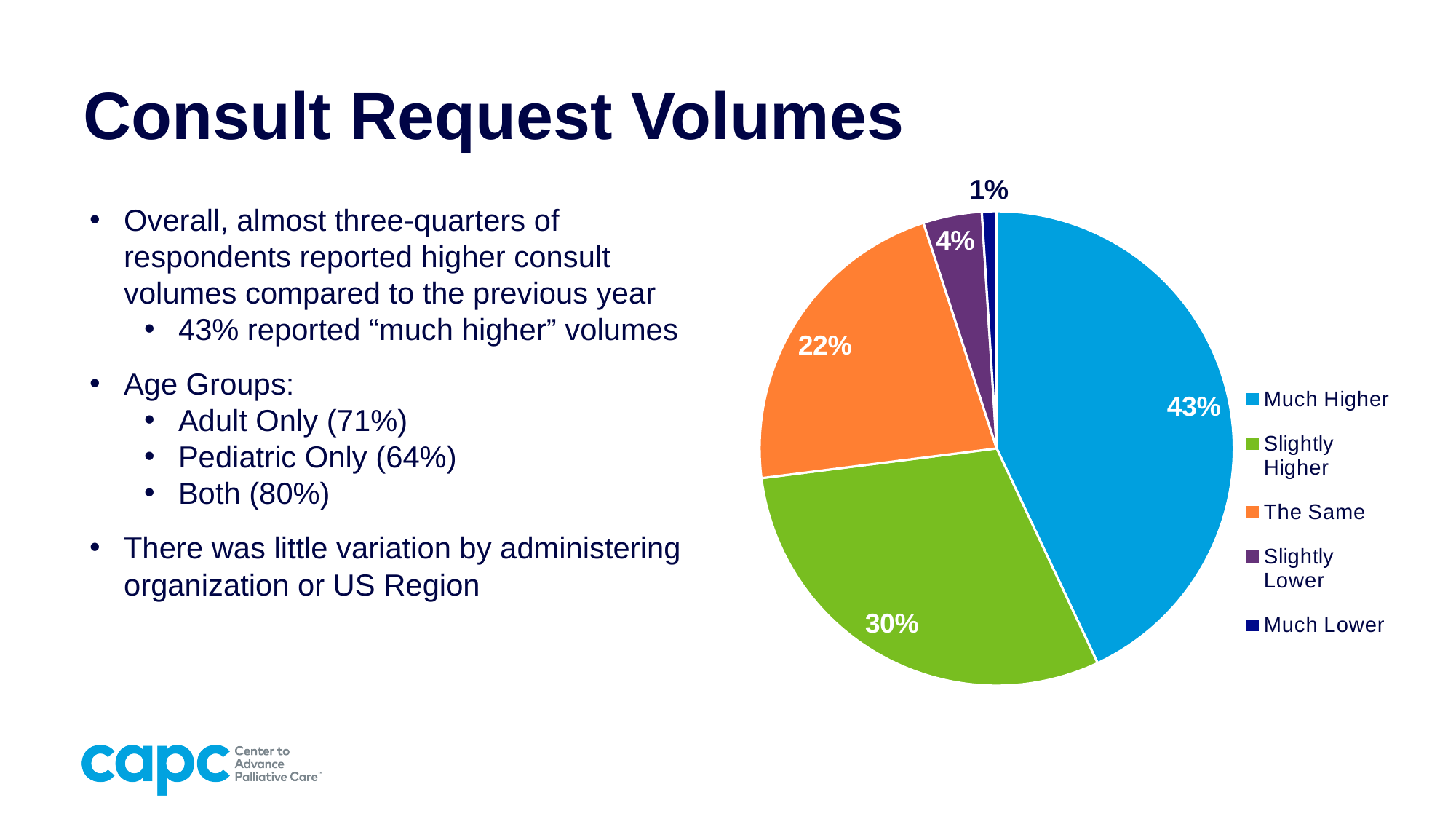
Which category has the largest slice of the pie chart? Much Higher What is the difference in percentage points between the "Much Higher" and "Slightly Higher" slices? 13 Which slice is larger, "The Same" or "Slightly Lower"? The Same What colour is the "The Same" slice in the pie chart? Orange What share of the pie chart is labelled "Slightly Higher"? 30% Which category has the smallest slice of the pie chart? Much Lower What percentage does the "Slightly Lower" slice show? 4% What percentage does the "The Same" slice show? 22% What type of chart is shown on the slide? Pie chart How many categories does the pie chart have? 5 What percentage does the "Much Lower" slice show? 1% What percentage of respondents reported "Much Higher" consult volumes in the pie chart? 43%